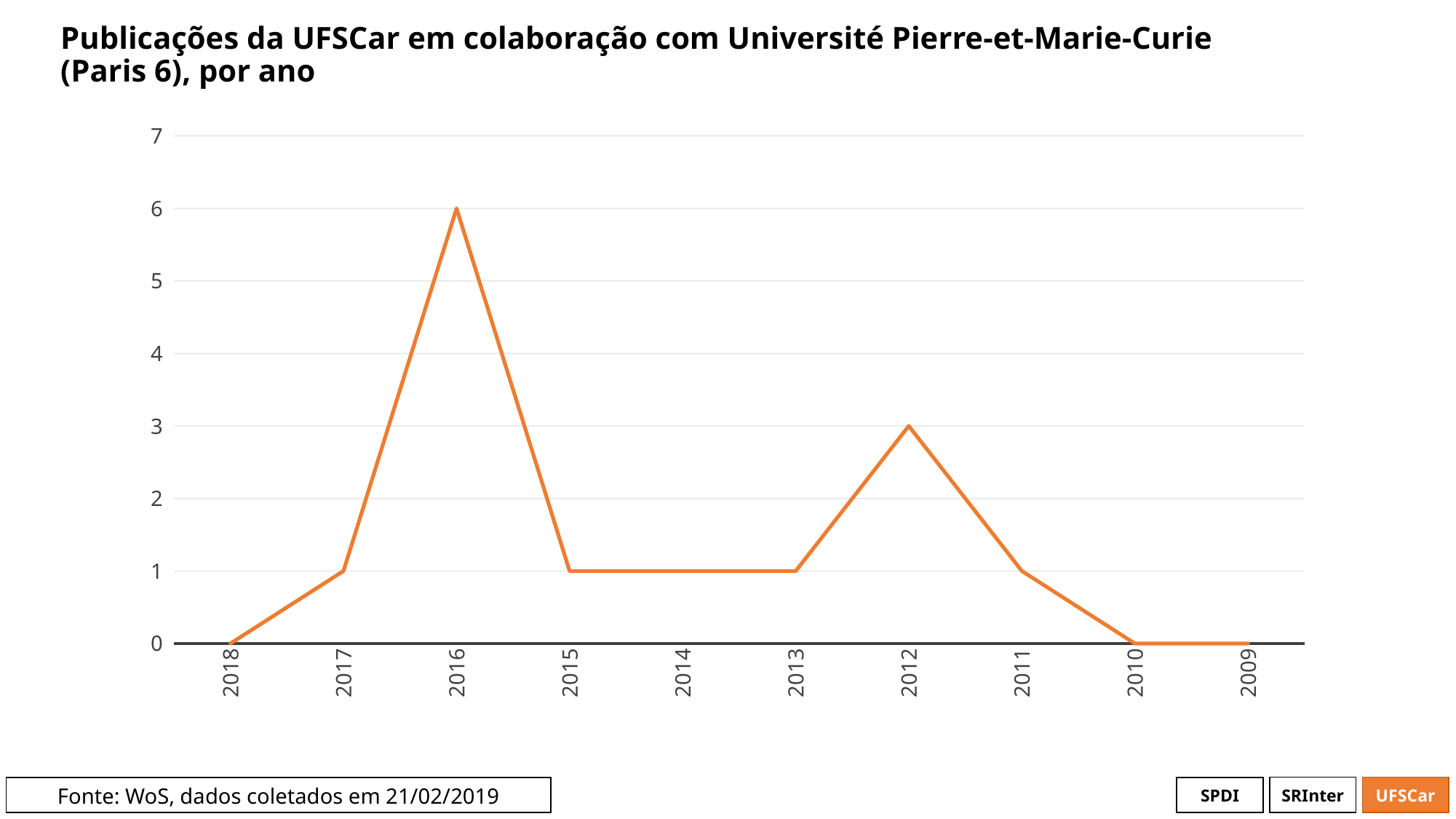
Which is larger, the value for 2012 or the value for 2011? 2012 How many years are shown on the x axis? 10 Which year has the highest value? 2016 What is the value for 2012? 3 What is the value for 2018? 0 Moving along the x axis from 2017 to 2016, does the line rise or fall? rise What is the value for 2016? 6 What is the difference between the values for 2016 and 2012? 3 What is the source of the data stated at the bottom of the slide? WoS, dados coletados em 21/02/2019 What is the value for 2014? 1 What kind of chart is shown on the slide? line chart Is the value for 2016 greater or less than 5? greater